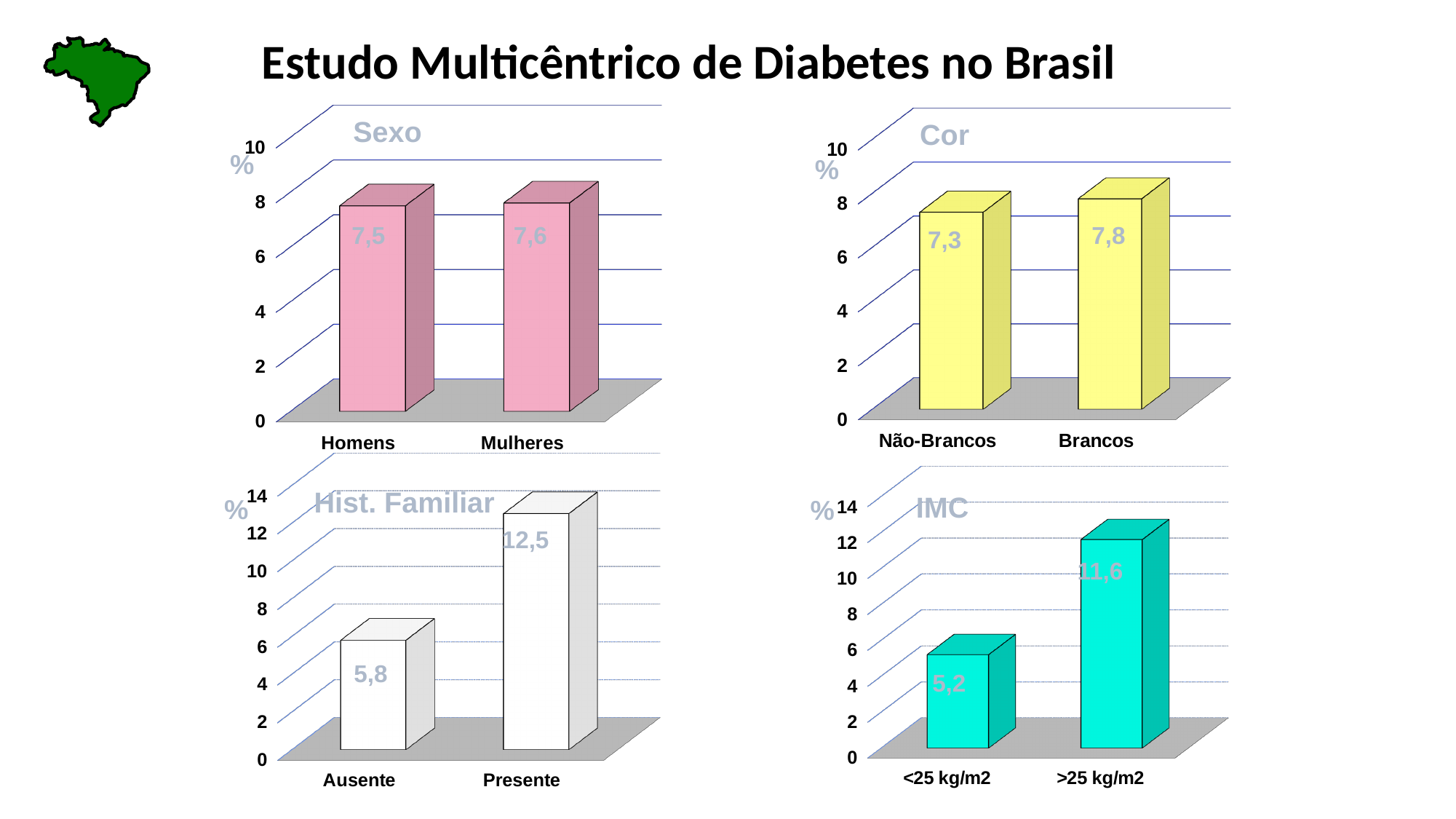
In the Sexo chart, what is the value for Mulheres? 7,6 In the IMC chart, what is the value for <25 kg/m2? 5,2 In the Hist. Familiar chart, what is the difference between Presente and Ausente? 6,7 In the IMC chart, which category has the lowest value? <25 kg/m2 In the Cor chart, what is the value for Brancos? 7,8 In the Sexo chart, what is the value for Homens? 7,5 How many categories does the Cor chart show? 2 In the Hist. Familiar chart, which category has the highest value? Presente What kind of chart is the IMC chart? bar chart In the Hist. Familiar chart, what is the value for Presente? 12,5 In the Cor chart, what is the difference between the values for Brancos and Não-Brancos? 0,5 In the IMC chart, is the value for >25 kg/m2 greater or less than 10? greater